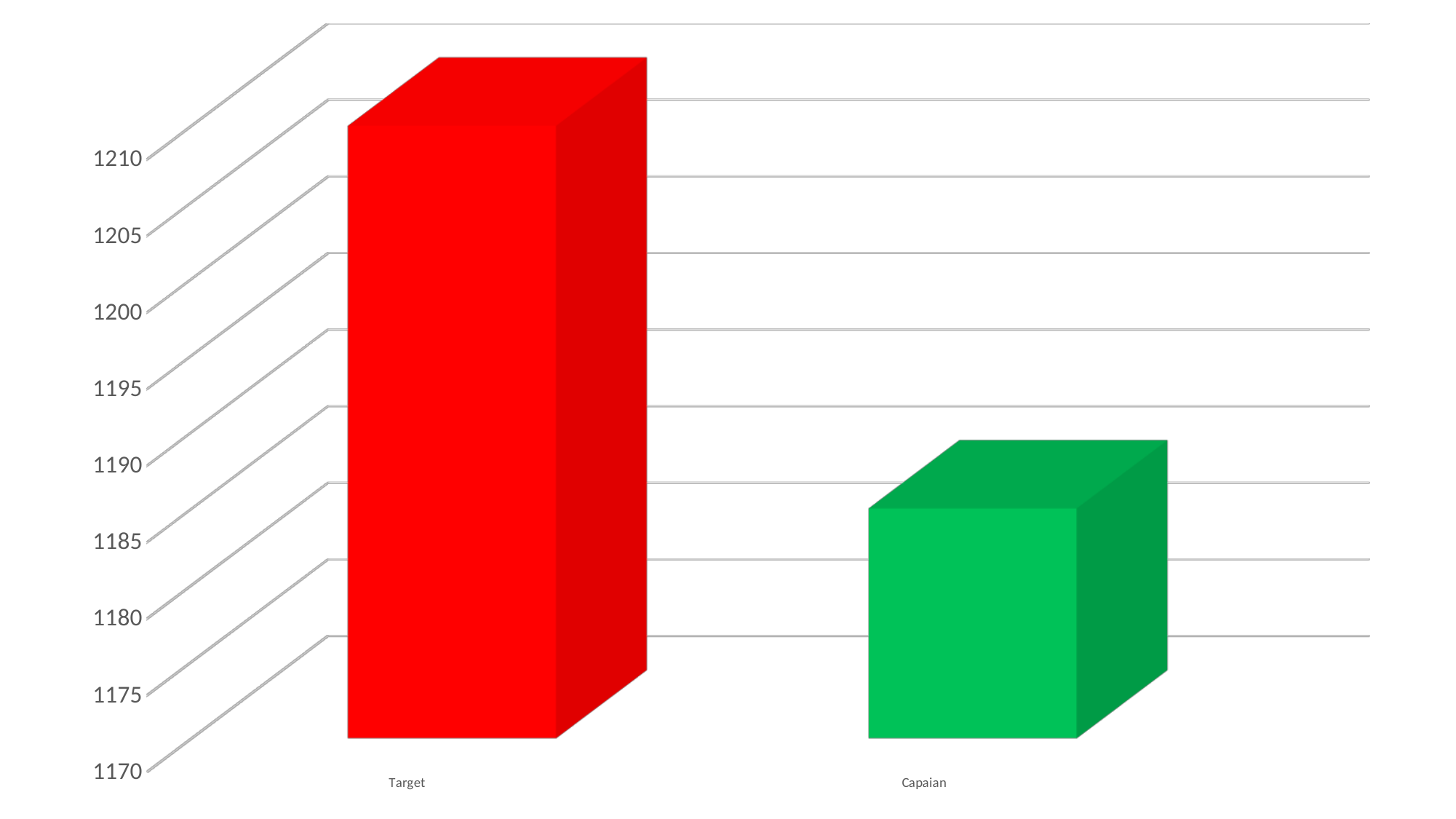
Is the value for Target greater or less than 1205? greater Which is larger, the value for Target or the value for Capaian? Target Is the value for Capaian greater or less than 1190? less What colour is the bar for Target? red Which category has the highest value? Target What colour is the bar for Capaian? green How many categories are plotted on the chart? 2 Is the value for Capaian greater or less than 1180? greater Which category has the lowest value? Capaian What kind of chart is shown on the slide? bar chart